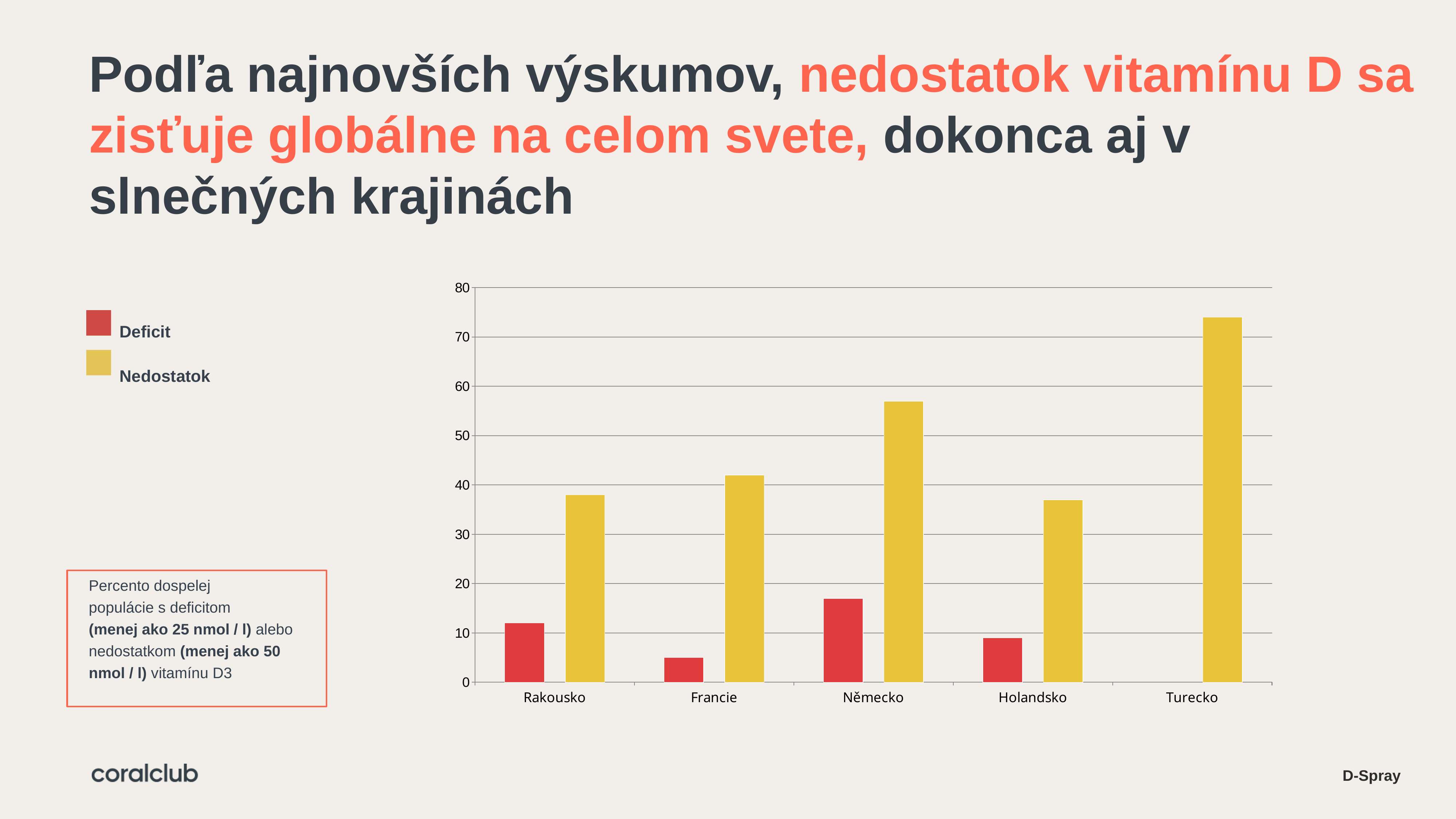
Is the Nedostatok value for Německo greater or less than 50? greater How many series does the chart legend list? 2 What colour represents the Deficit series in the legend? red Which country has the highest Deficit value? Německo Which is larger, the Nedostatok value for Německo or for Francie? Německo Is the Nedostatok value for Rakousko greater or less than 40? less Which is larger, the Deficit value for Rakousko or for Holandsko? Rakousko What kind of chart is shown on the slide? bar chart Is the Deficit value for Francie greater or less than 10? less How many countries are shown on the x axis of the chart? 5 Which country has the highest Nedostatok value? Turecko